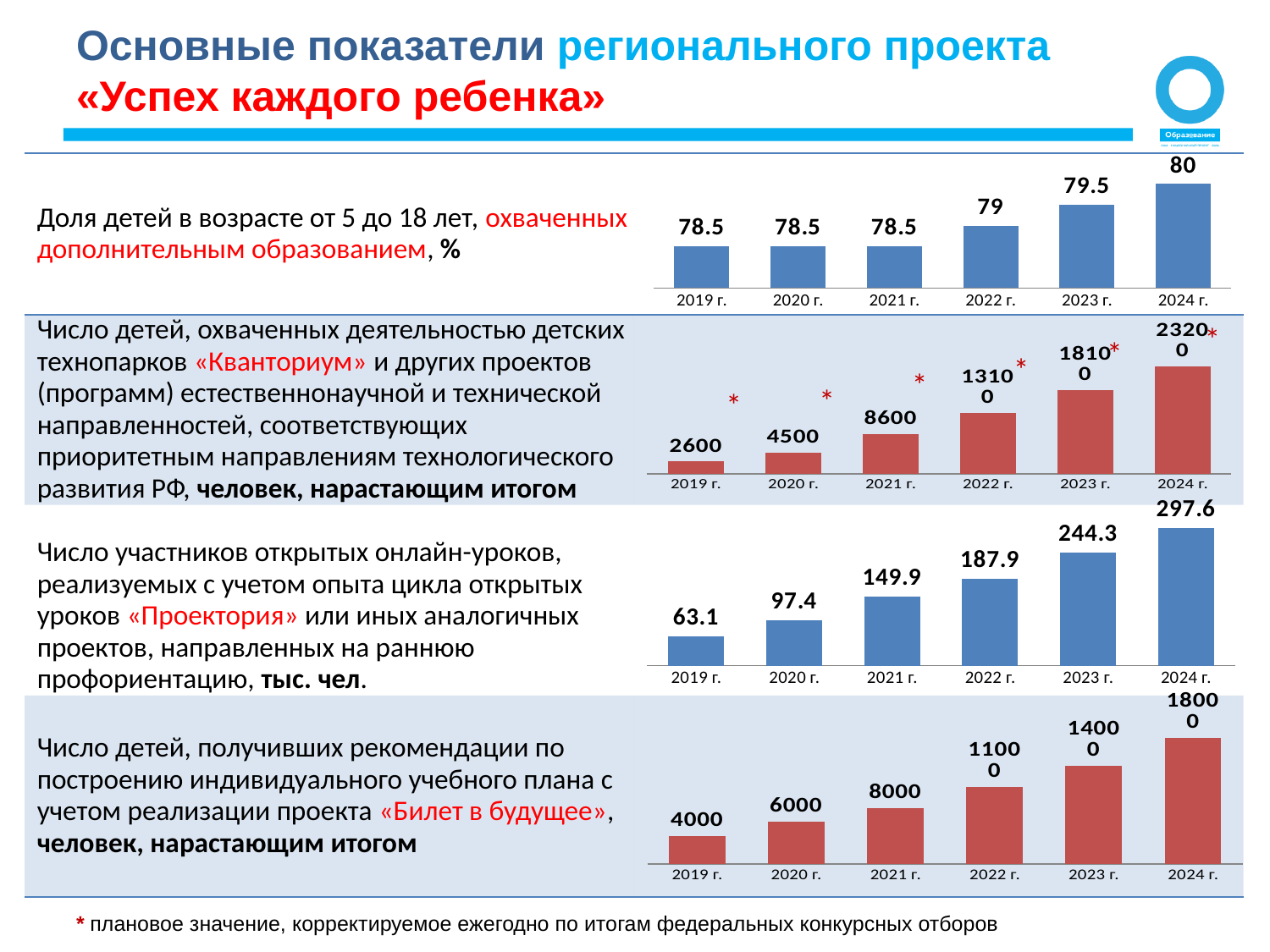
In the second chart (children covered by «Кванториум» technoparks), what is the value for 2021 г.? 8600 In the third chart (participants of open online lessons «Проектория»), do the values rise or fall from 2019 г. to 2024 г.? rise In the top chart on the share of children covered by additional education, by how much does the 2024 г. value exceed the 2019 г. value? 1.5 In the top chart on the share of children covered by additional education, what is the value for 2022 г.? 79 In the second chart (children covered by «Кванториум» technoparks), which year has the highest value? 2024 г. In the third chart (participants of open online lessons «Проектория», тыс. чел.), what is the value for 2023 г.? 244.3 In the second chart (children covered by «Кванториум» technoparks), what is the difference between the 2020 г. and 2019 г. values? 1900 In the top chart on the share of children covered by additional education, how many years are plotted? 6 In the top chart on the share of children aged 5 to 18 covered by additional education, what is the value for 2024 г.? 80 What type of chart is the bottom chart (children who received recommendations under «Билет в будущее»)? bar chart In the bottom chart (children who received recommendations under «Билет в будущее»), what is the value for 2022 г.? 11000 In the third chart (participants of open online lessons «Проектория»), which year has the lowest value? 2019 г.